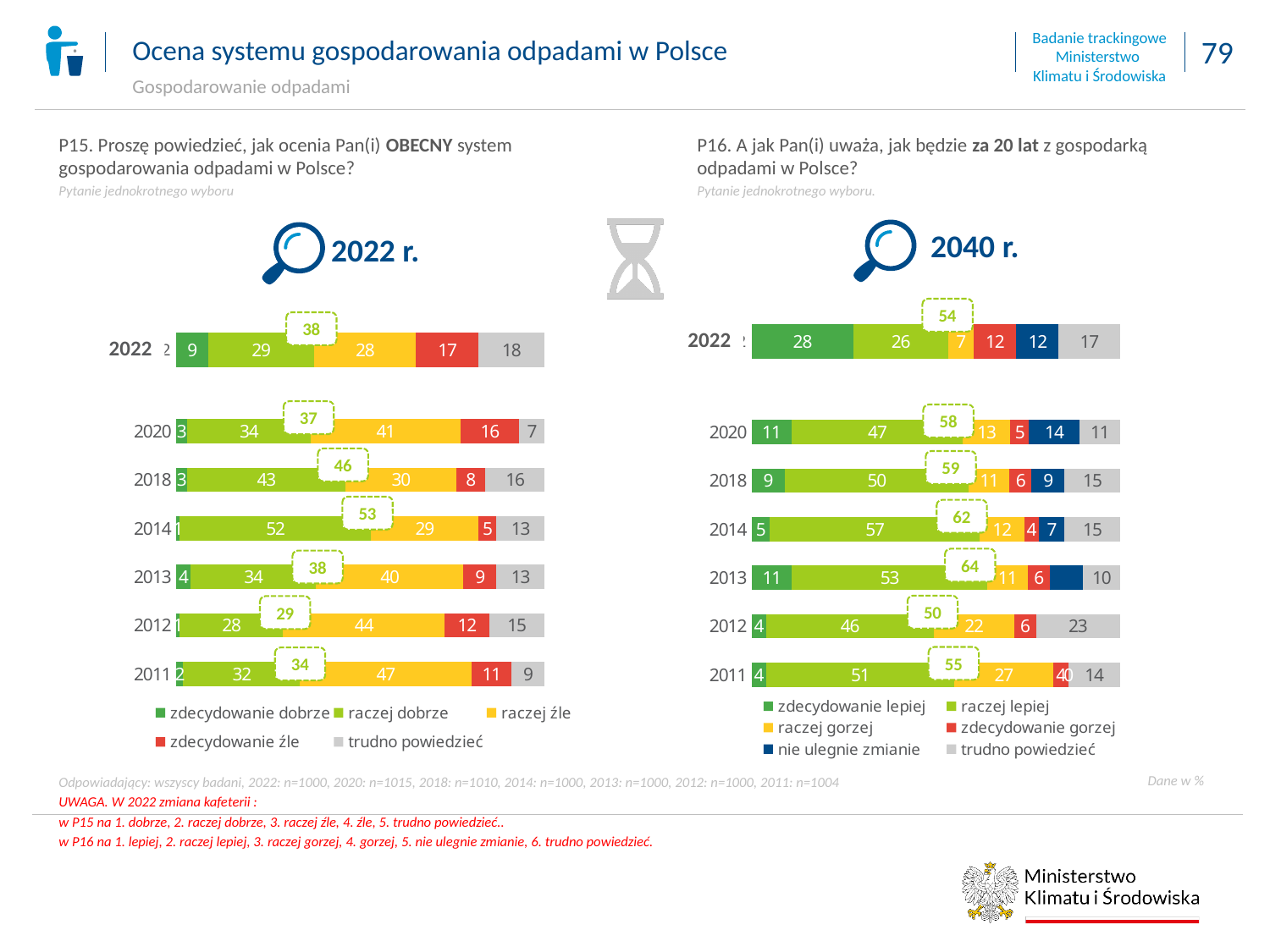
What kind of chart is the left chart (P15, 2022 r.)? Stacked horizontal bar chart In the left chart (P15, 2022 r.), what is the value for "trudno powiedzieć" in the 2022 bar? 18 In the left chart (P15, 2022 r.), what is the value for "raczej źle" in the 2011 bar? 47 In the right chart (P16, 2040 r.), what is the value for "raczej gorzej" in the 2012 bar? 22 How many series does the legend of the left chart (P15, 2022 r.) list? 5 In the left chart (P15, 2022 r.), what is the difference between the "raczej źle" values for 2011 and 2022? 19 In the left chart (P15, 2022 r.), what is the value for "raczej dobrze" in the 2022 bar? 29 How many series does the legend of the right chart (P16, 2040 r.) list? 6 In the left chart (P15, 2022 r.), which year has the highest value for "raczej dobrze"? 2014 In the right chart (P16, 2040 r.), what is the value for "zdecydowanie lepiej" in the 2022 bar? 28 In the right chart (P16, 2040 r.), which is larger in the 2022 bar: "zdecydowanie lepiej" or "raczej lepiej"? zdecydowanie lepiej In the right chart (P16, 2040 r.), which year has the highest value for "raczej lepiej"? 2014